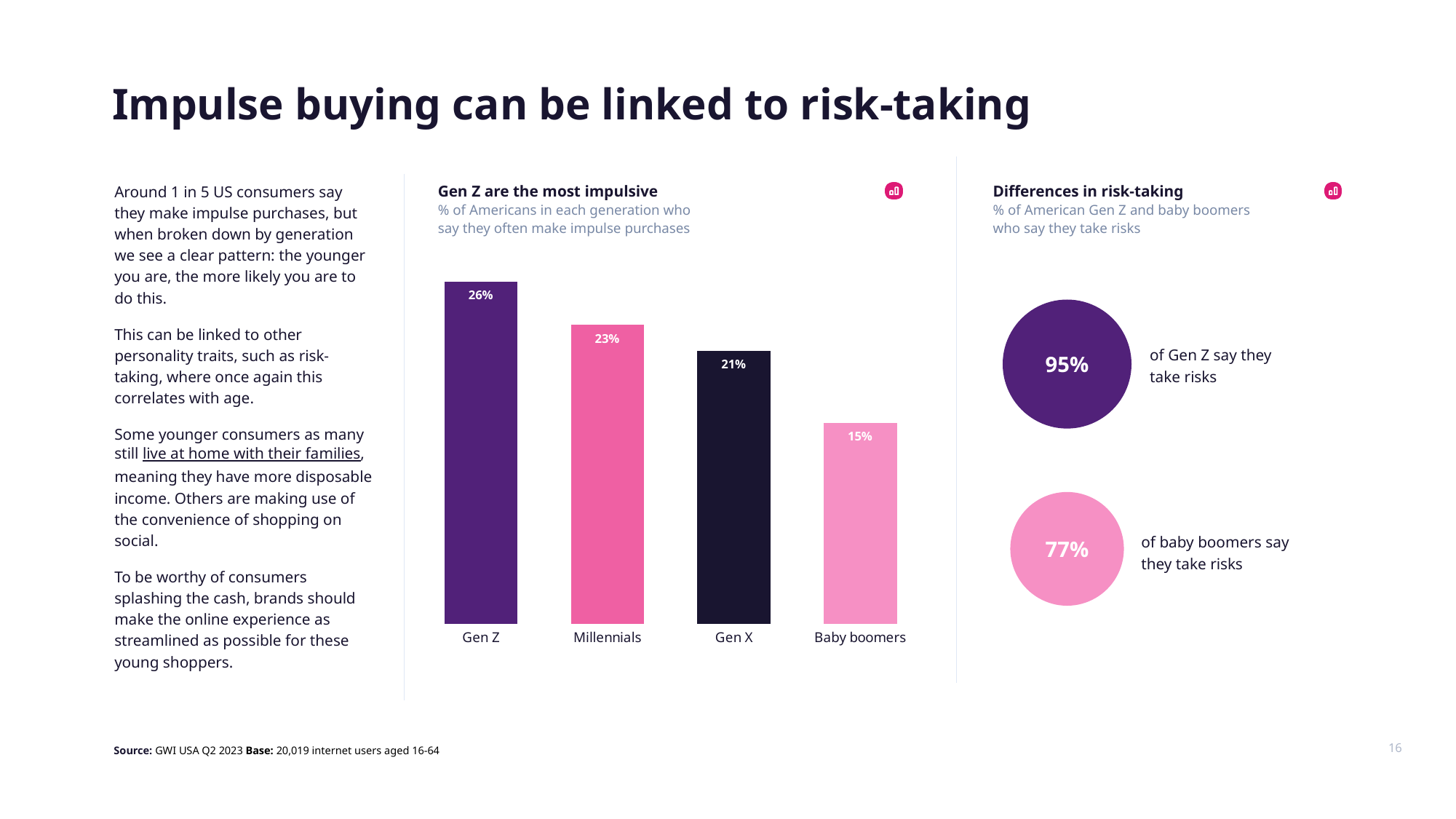
In the 'Gen Z are the most impulsive' chart, what is the difference between the Gen Z and Baby boomers values? 11% In the 'Gen Z are the most impulsive' chart, which is larger: the value for Millennials or the value for Gen X? Millennials What kind of chart is 'Gen Z are the most impulsive'? Bar chart In the 'Gen Z are the most impulsive' chart, which generation has the lowest value? Baby boomers In the 'Gen Z are the most impulsive' chart, what is the value for Millennials? 23% In the 'Differences in risk-taking' chart, what percentage of baby boomers say they take risks? 77% In the 'Gen Z are the most impulsive' chart, what is the value for Baby boomers? 15% In the 'Gen Z are the most impulsive' chart, what percentage of Gen Z say they often make impulse purchases? 26% How many generations are shown in the 'Gen Z are the most impulsive' chart? 4 In the 'Gen Z are the most impulsive' chart, which generation has the highest value? Gen Z In the 'Gen Z are the most impulsive' chart, what is the value for Gen X? 21% In the 'Gen Z are the most impulsive' chart, do the values rise or fall from Gen Z to Baby boomers? Fall